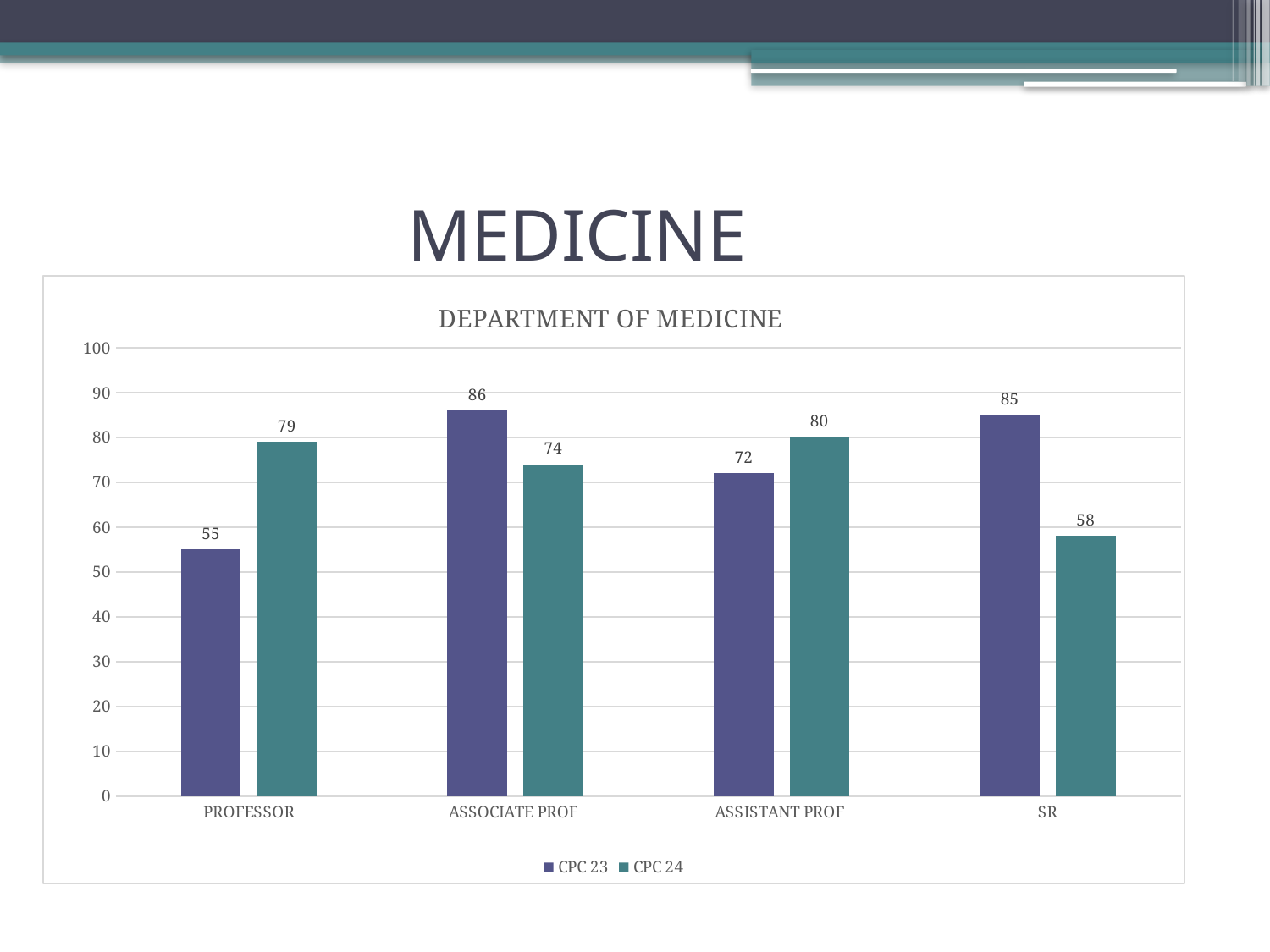
How many series does the legend list? 2 Which category has the lowest CPC 24 value? SR For ASSOCIATE PROF, which is larger: CPC 23 or CPC 24? CPC 23 What is the CPC 24 value for SR? 58 What is the title of the chart? DEPARTMENT OF MEDICINE What is the CPC 23 value for PROFESSOR? 55 How many categories are shown on the x axis? 4 What is the CPC 24 value for ASSISTANT PROF? 80 Which category has the highest CPC 23 value? ASSOCIATE PROF What is the difference between the CPC 24 and CPC 23 values for PROFESSOR? 24 What is the difference between the CPC 23 and CPC 24 values for SR? 27 What kind of chart is shown on the slide? Bar chart